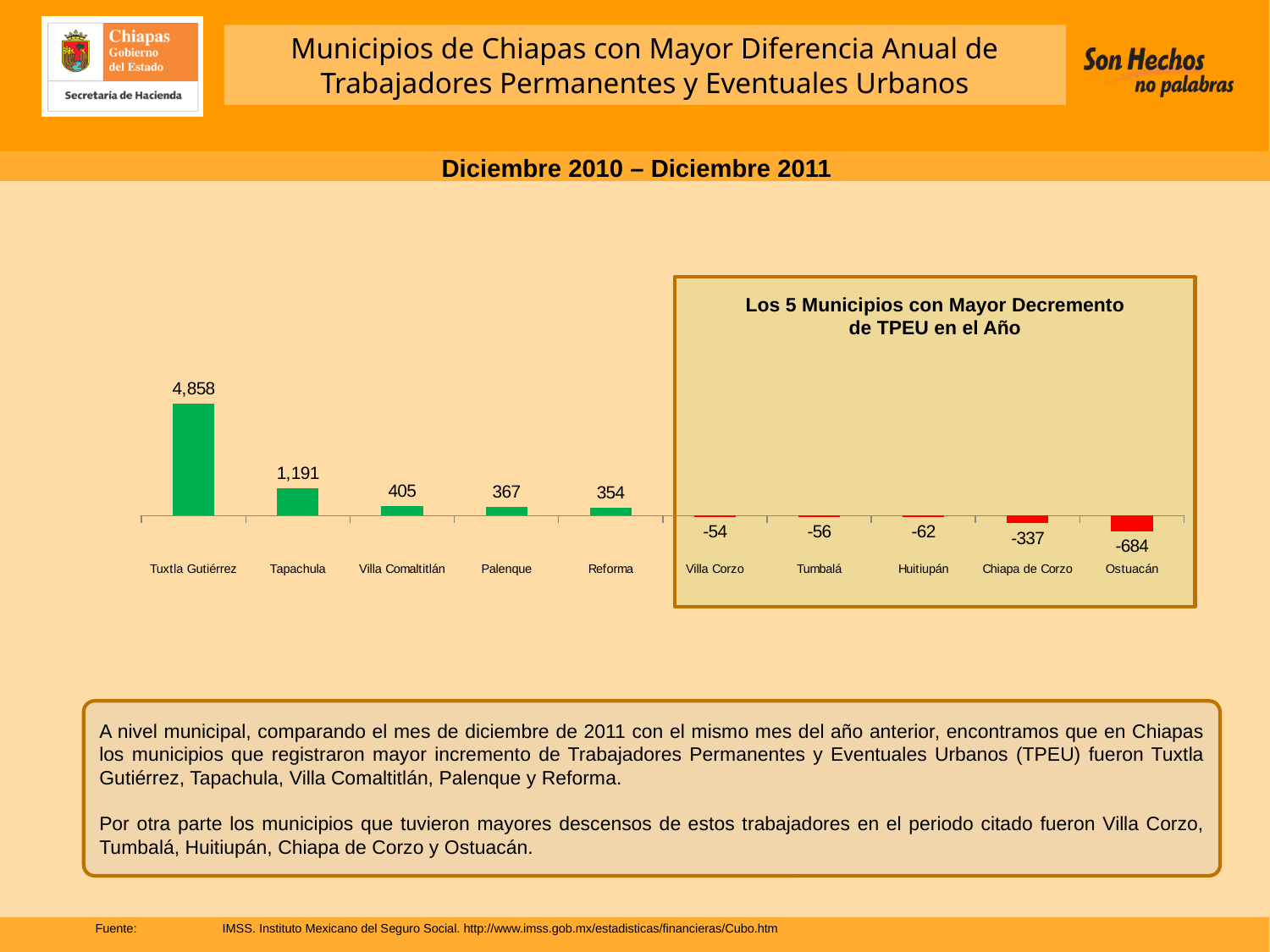
What is the value shown for Chiapa de Corzo? -337 What is the value shown for Tapachula? 1,191 What is the title of the boxed section on the right side of the chart? Los 5 Municipios con Mayor Decremento de TPEU en el Año What is the value shown for Ostuacán? -684 What is the difference between the values for Tuxtla Gutiérrez and Tapachula? 3,667 What is the difference between the values for Villa Comaltitlán and Reforma? 51 Which is larger, the value for Palenque or the value for Reforma? Palenque What is the value shown for Tuxtla Gutiérrez? 4,858 How many municipalities are shown on the chart? 10 Which municipality has the lowest value on the chart? Ostuacán What kind of chart is shown on the slide? Bar chart Which municipality has the highest value on the chart? Tuxtla Gutiérrez